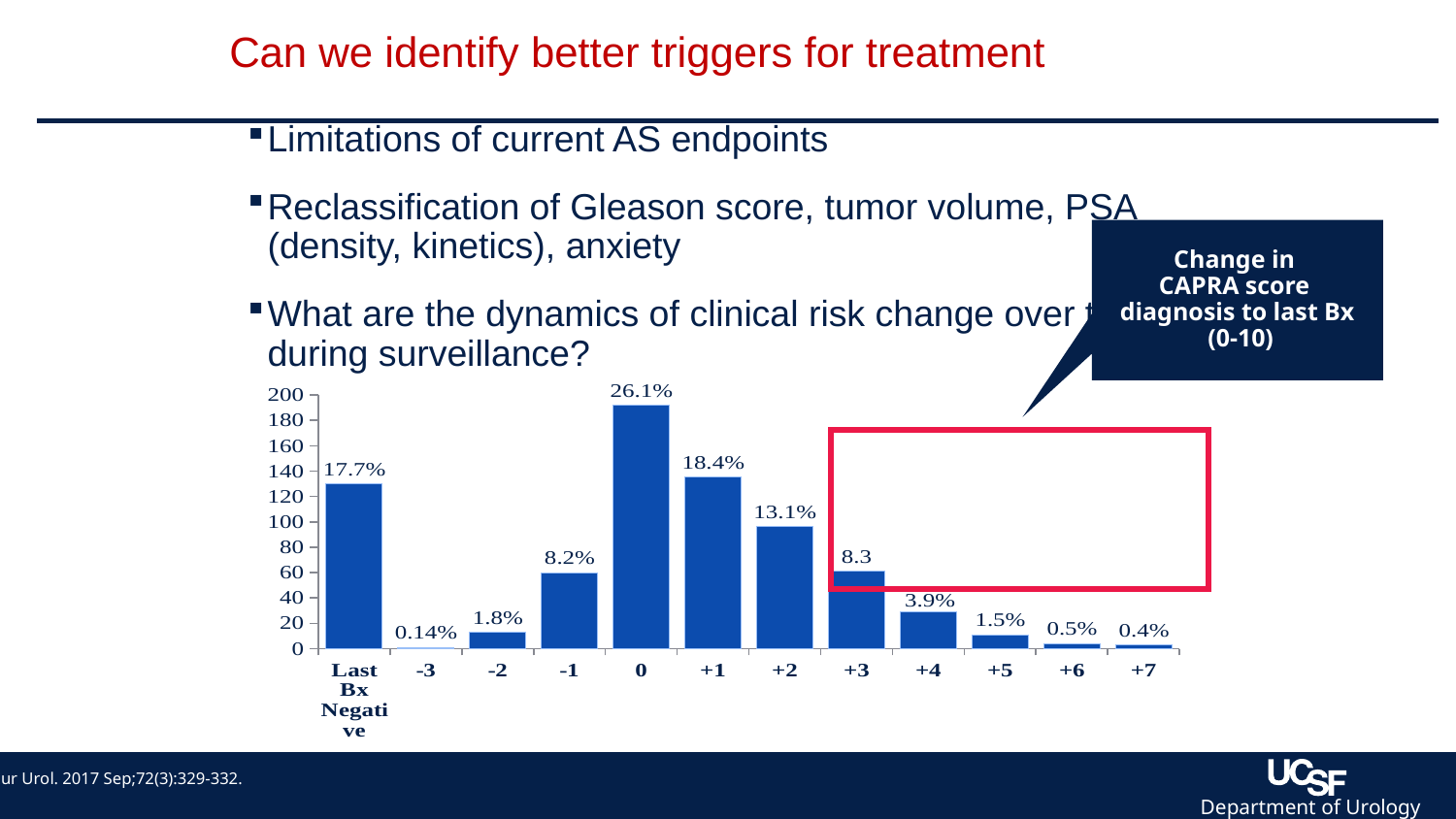
What is the difference between the data labels for category 0 and category +1? 7.7% Is the value for category 0 greater or less than 180? greater What kind of chart is shown on the slide? bar chart Which category has the lowest bar in the chart? -3 Which category has the highest bar in the chart? 0 What data label is shown on the bar for 'Last Bx Negative'? 17.7% Which bar is taller, +1 or +2? +1 What data label is shown on the bar for category 0? 26.1% How many categories are shown on the x axis of the chart? 12 What data label is shown on the bar for category +3? 8.3 What data label is shown on the bar for category -3? 0.14%